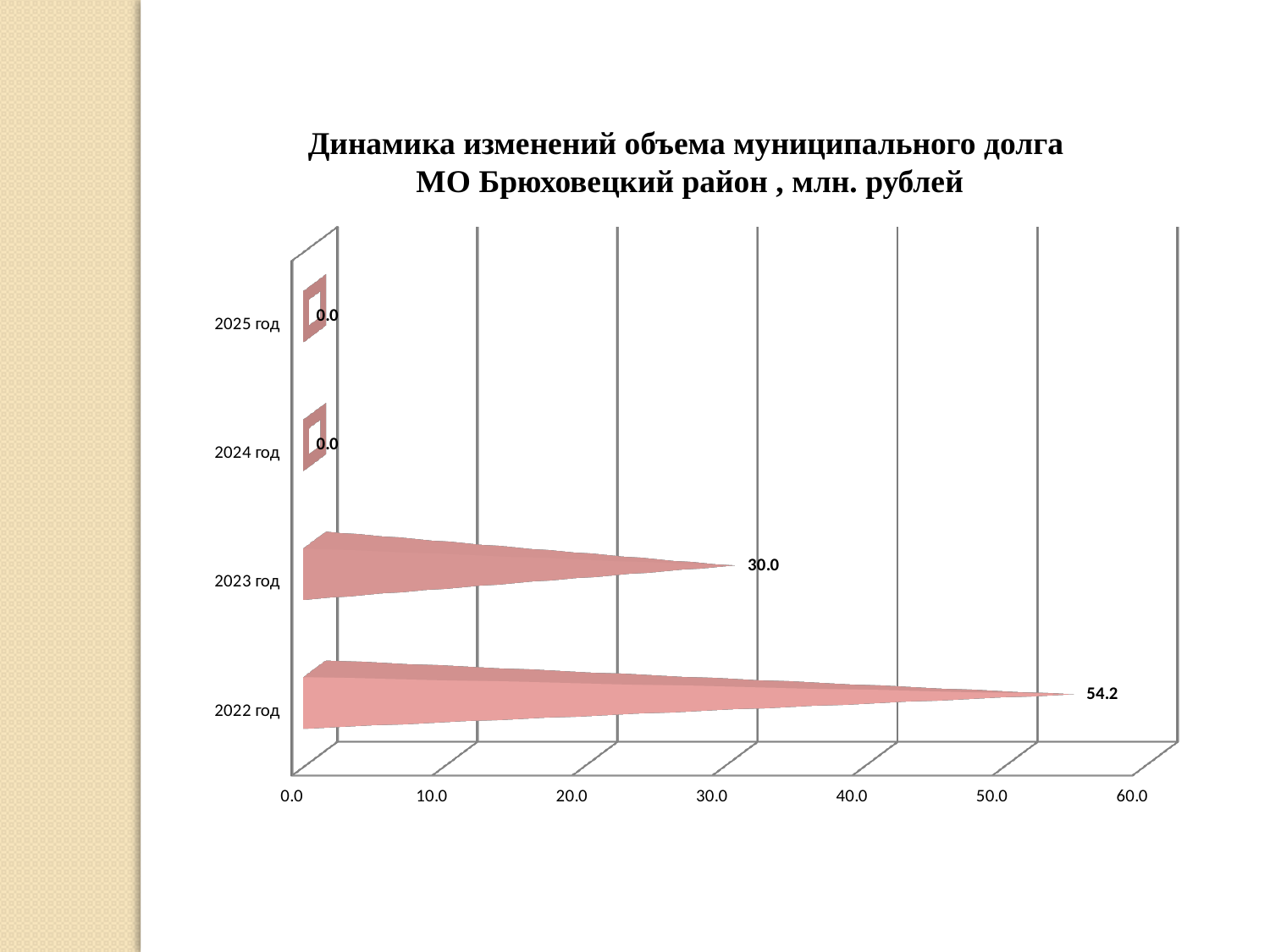
What is the value for 2024 год? 0.0 Do the values rise or fall from 2022 год to 2025 год? fall Which is larger, the value for 2022 год or the value for 2023 год? 2022 год What is the title of the chart? Динамика изменений объема муниципального долга МО Брюховецкий район , млн. рублей Is the value for 2022 год greater or less than 50.0? greater How many years are shown on the chart? 4 What is the difference between the values for 2022 год and 2023 год? 24.2 What kind of chart is this? bar chart Which year has the highest value? 2022 год What is the value for 2025 год? 0.0 What is the value for 2022 год? 54.2 What is the value for 2023 год? 30.0